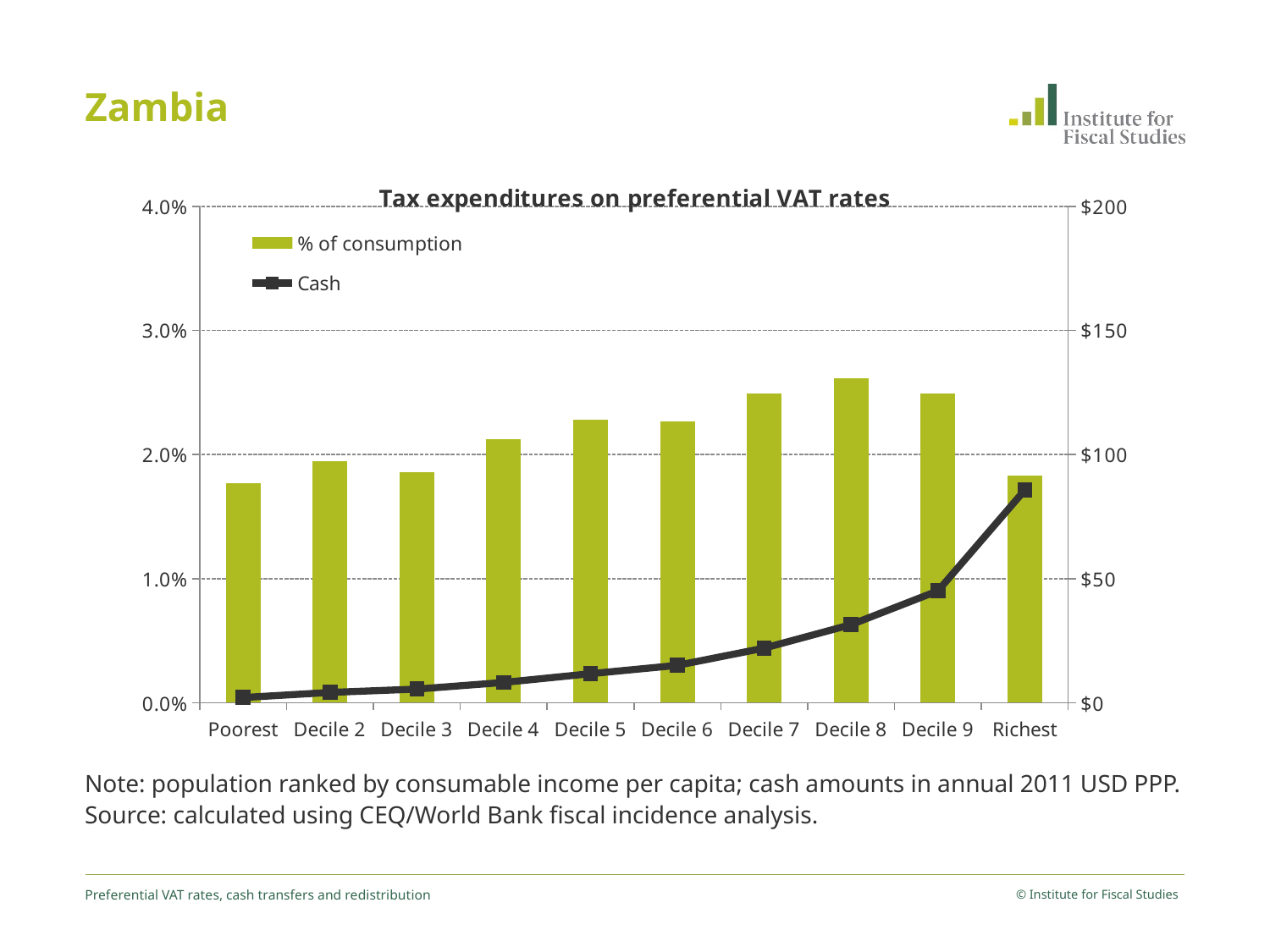
What is the title of the chart? Tax expenditures on preferential VAT rates Which decile has the highest Cash value? Richest Does the Cash series rise or fall moving from the Poorest to the Richest decile? rise Which decile has the highest value for % of consumption? Decile 8 How many decile categories are shown on the x axis? 10 Is the % of consumption value for the Poorest decile greater or less than 2.0%? less Is the % of consumption value for Decile 8 greater or less than 2.0%? greater Which has a larger % of consumption value, Decile 4 or Decile 2? Decile 4 How many series does the legend list? 2 Is the Cash value for the Richest decile greater or less than $100? less Which decile has the lowest Cash value? Poorest What kind of chart is shown on the slide? A combined bar and line chart